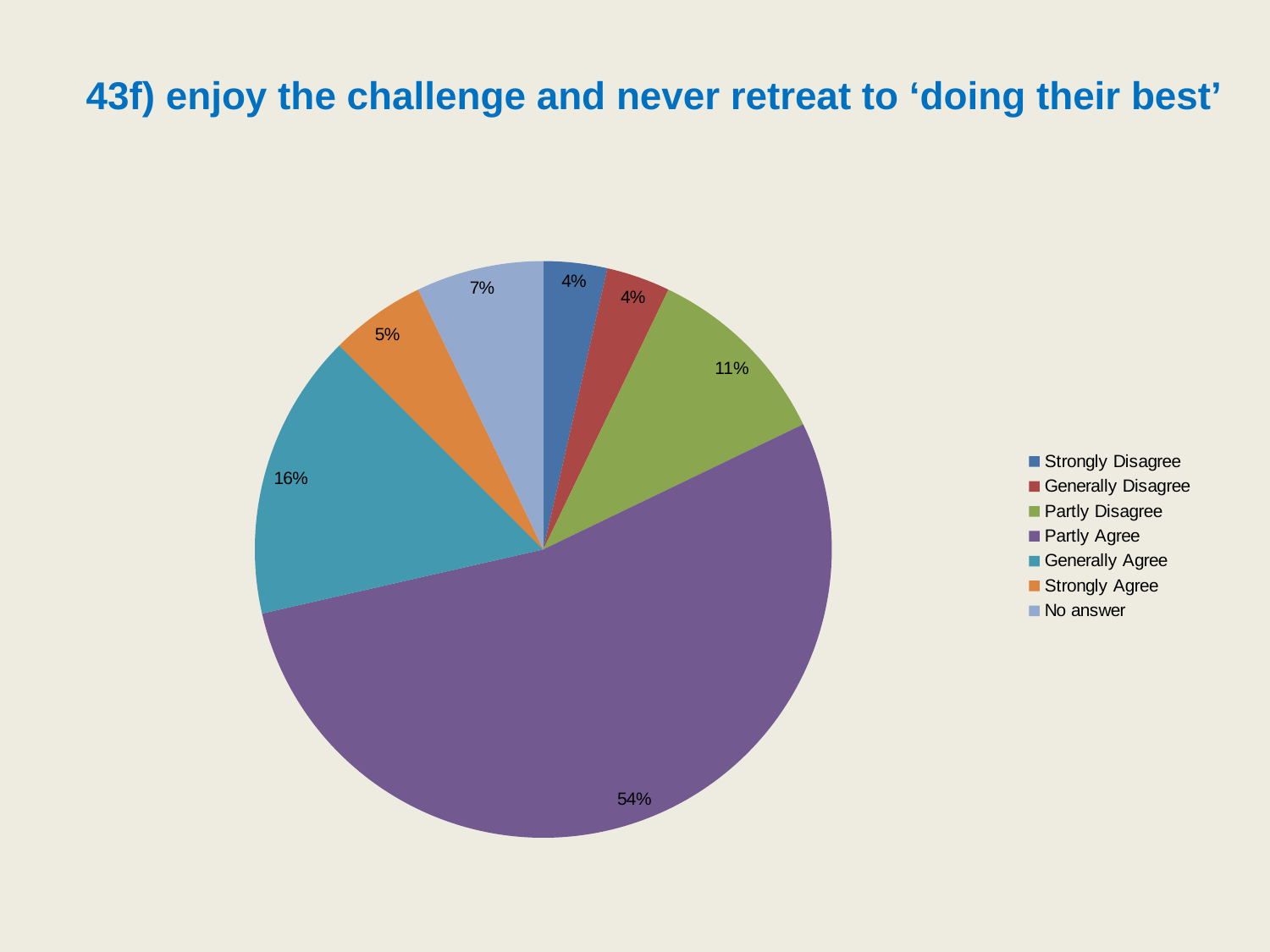
Which is larger, the Partly Disagree slice or the No answer slice? Partly Disagree What share of the pie is Partly Disagree? 11% What share of the pie is No answer? 7% How many categories does the legend list? 7 What share of the pie is Generally Agree? 16% What is the difference between the Generally Agree and Strongly Agree shares? 11% What is the title of the chart on the slide? 43f) enjoy the challenge and never retreat to 'doing their best' Which category has the largest slice of the pie? Partly Agree What kind of chart is shown on the slide? pie chart What is the difference between the Partly Agree and Generally Agree shares? 38%